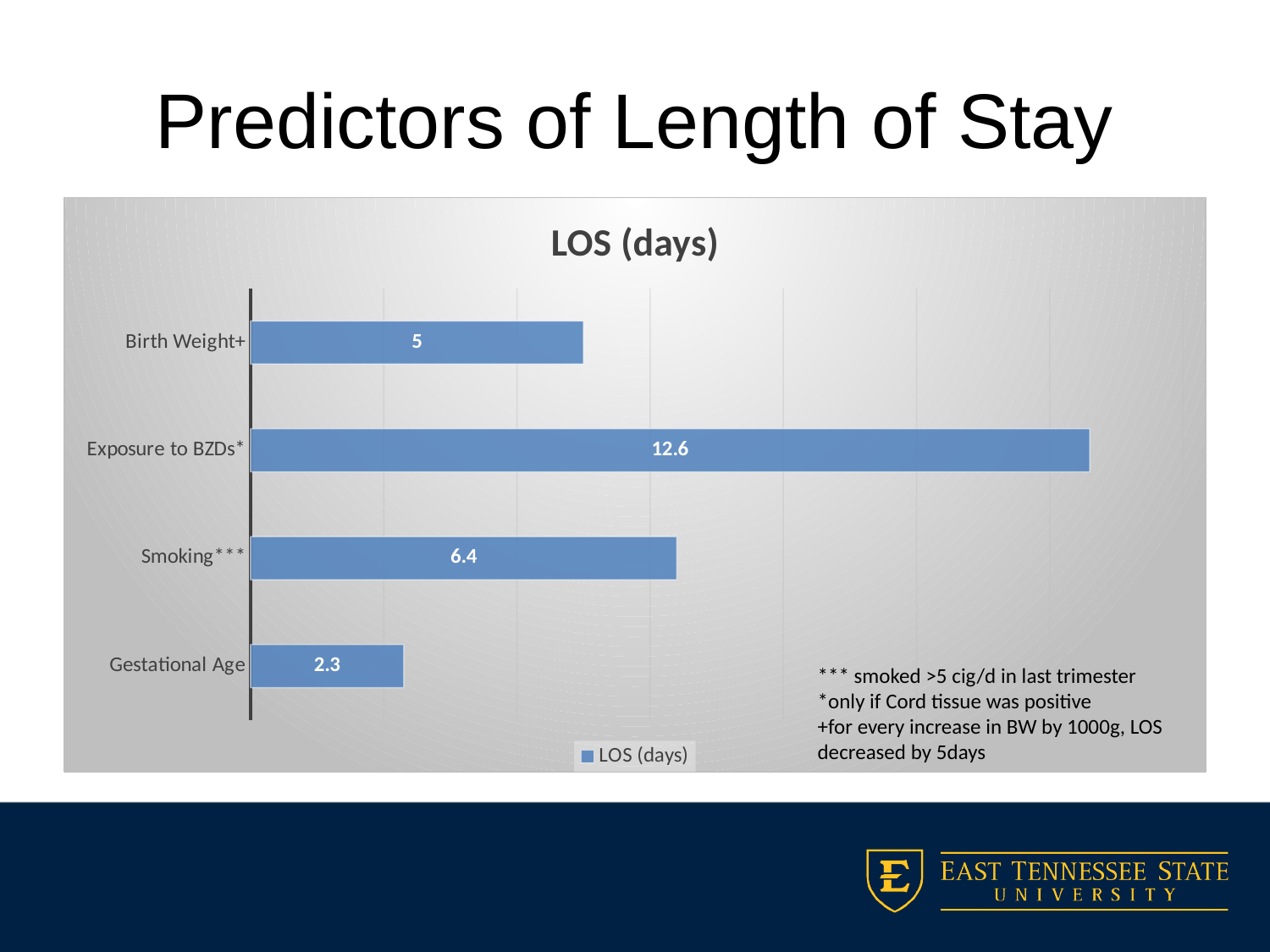
Which category has the highest LOS (days) value? Exposure to BZDs* What kind of chart is shown on the slide? Bar chart What is the title of the chart? LOS (days) What is the LOS (days) value for Birth Weight+? 5 What is the LOS (days) value for Exposure to BZDs*? 12.6 What is the LOS (days) value for Gestational Age? 2.3 Which has a larger LOS (days) value, Smoking*** or Birth Weight+? Smoking*** What is the LOS (days) value for Smoking***? 6.4 How many series does the legend list? 1 What is the difference between the LOS (days) values for Exposure to BZDs* and Smoking***? 6.2 How many categories are shown in the chart? 4 Which category has the lowest LOS (days) value? Gestational Age